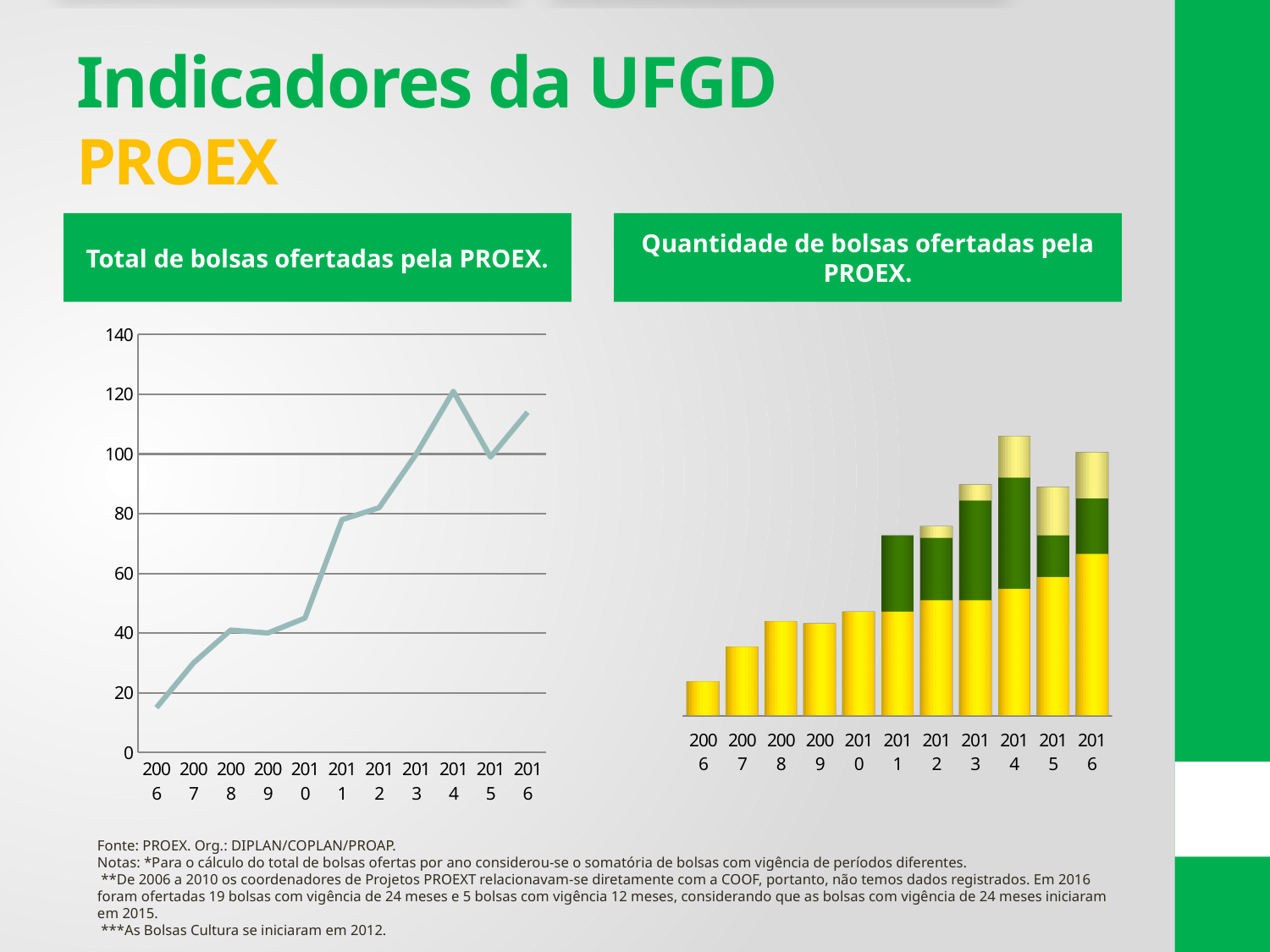
In the chart "Total de bolsas ofertadas pela PROEX.", which is larger, the value for 2014 or the value for 2015? 2014 In the chart "Quantidade de bolsas ofertadas pela PROEX.", which year has the tallest stacked bar? 2014 In the chart "Total de bolsas ofertadas pela PROEX.", is the value for 2006 greater or less than 20? less What type of chart is the chart titled "Quantidade de bolsas ofertadas pela PROEX."? bar chart How many years are shown on the x axis of the chart "Total de bolsas ofertadas pela PROEX."? 11 In the chart "Total de bolsas ofertadas pela PROEX.", which year has the lowest value? 2006 In the chart "Total de bolsas ofertadas pela PROEX.", is the value for 2016 greater or less than 100? greater In the chart "Total de bolsas ofertadas pela PROEX.", do the values generally rise or fall from 2006 to 2016? rise In the chart "Total de bolsas ofertadas pela PROEX.", which year has the highest value? 2014 What type of chart is the chart titled "Total de bolsas ofertadas pela PROEX."? line chart In the chart "Total de bolsas ofertadas pela PROEX.", is the value for 2014 greater or less than 100? greater In the chart "Quantidade de bolsas ofertadas pela PROEX.", which year has the shortest bar? 2006